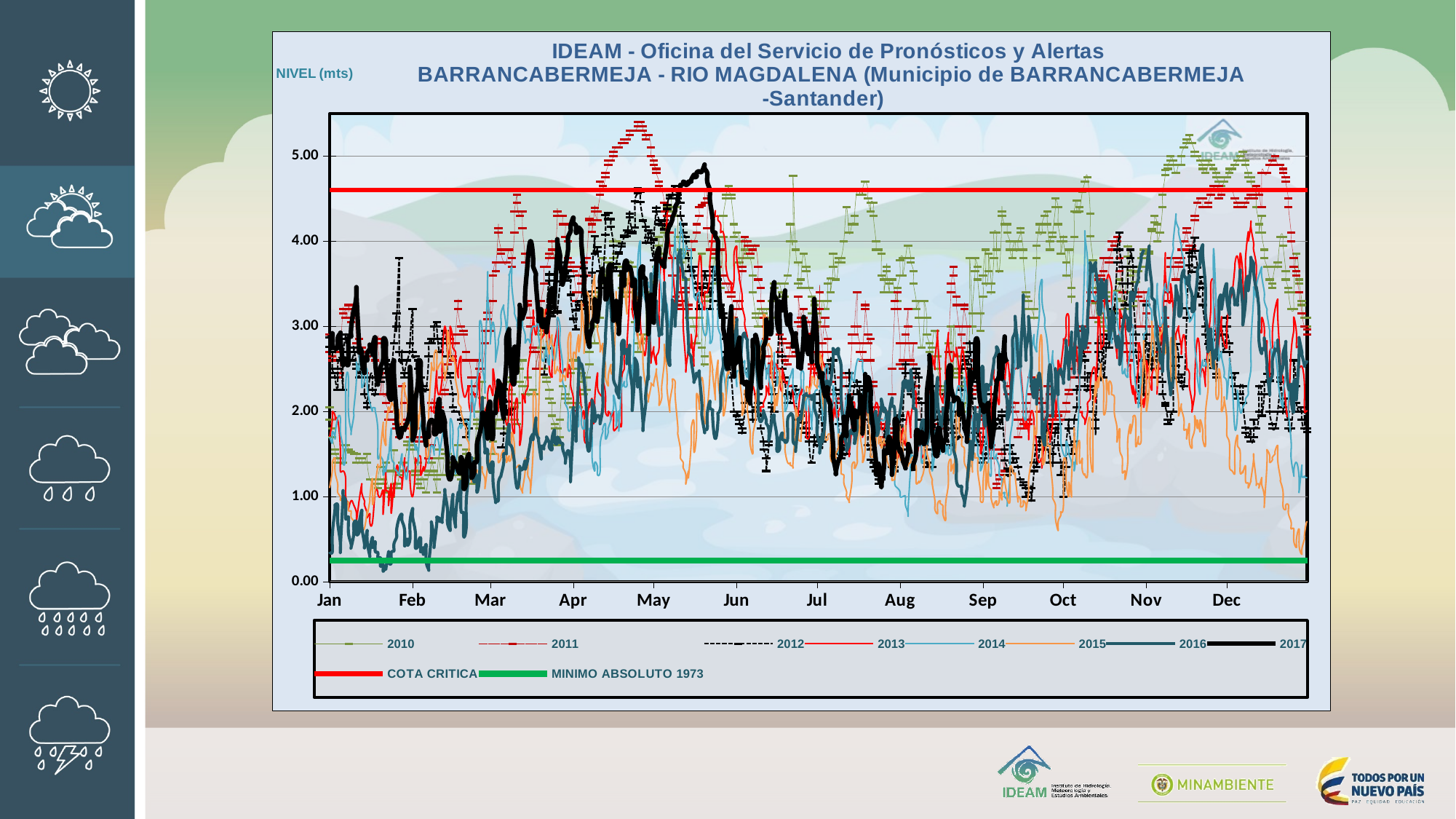
Is the MINIMO ABSOLUTO 1973 line greater or less than 1.00? less What is the label of the vertical axis of the chart? NIVEL (mts) Is the peak value of the 2011 series in May greater or less than 5.00? greater How many entries does the chart legend list? 10 Is the COTA CRITICA line greater or less than 5.00? less What does the red horizontal line on the chart represent, according to the legend? COTA CRITICA How many months are labelled along the x axis of the chart? 12 What kind of chart is shown on the slide? line chart